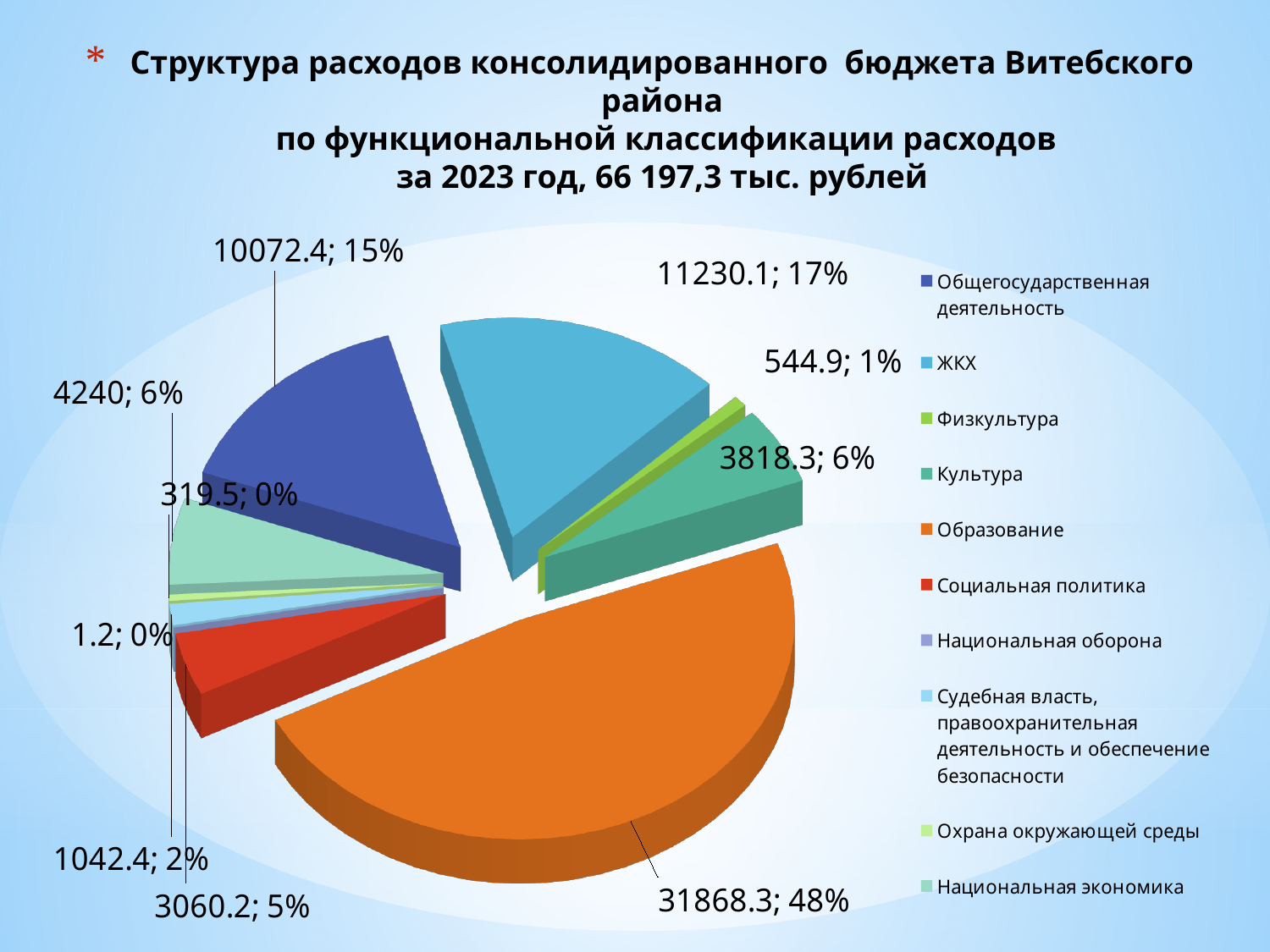
Which category has the largest slice of the pie? Образование What kind of chart is shown on the slide? pie chart Which category has the smallest value in the pie chart? Национальная оборона What total amount in thousand rubles is stated in the chart title for 2023? 66 197,3 тыс. рублей What value is shown for Культура? 3818.3 What value is shown for ЖКХ? 11230.1 How many categories does the legend of the pie chart list? 10 What is the difference between the values for ЖКХ and Общегосударственная деятельность? 1157.7 What share of the pie does Образование account for? 48% Which is larger, the value for ЖКХ or the value for Общегосударственная деятельность? ЖКХ What share of the pie does Общегосударственная деятельность account for? 15% What value is shown for Образование? 31868.3